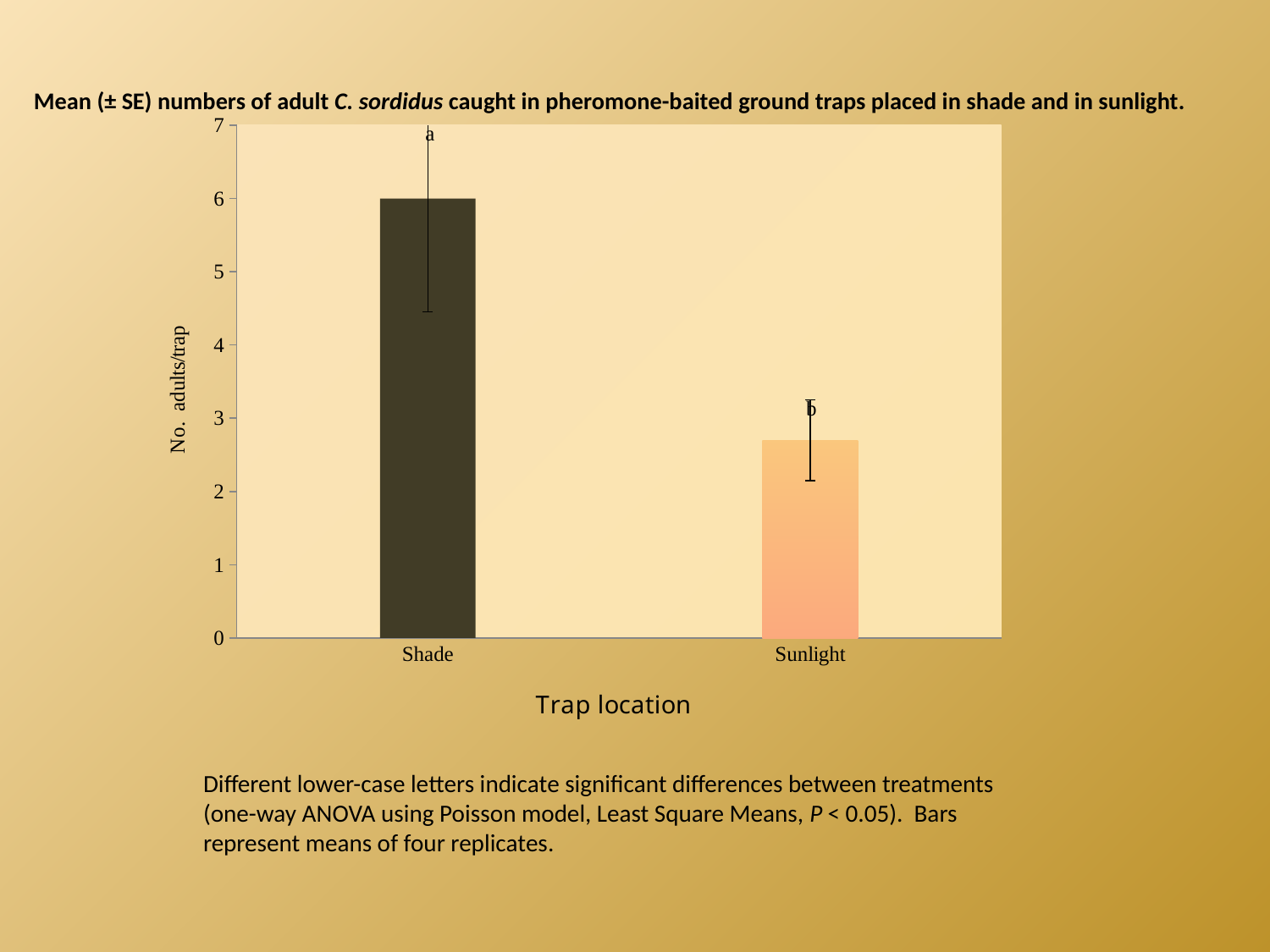
Which trap location has the lowest mean number of adults per trap? Sunlight Which has a larger value, Shade or Sunlight? Shade Is the value for Sunlight greater or less than 2? greater What kind of chart is shown on the slide? bar chart What is the highest value shown on the y axis? 7 Is the value for Shade greater or less than 5? greater What is the label of the x axis? Trap location What is the label of the y axis? No. adults/trap Which trap location has the highest mean number of adults per trap? Shade What is the mean number of adults per trap for Shade? 6 Is the value for Sunlight greater or less than 3? less How many trap locations are plotted on the x axis? 2